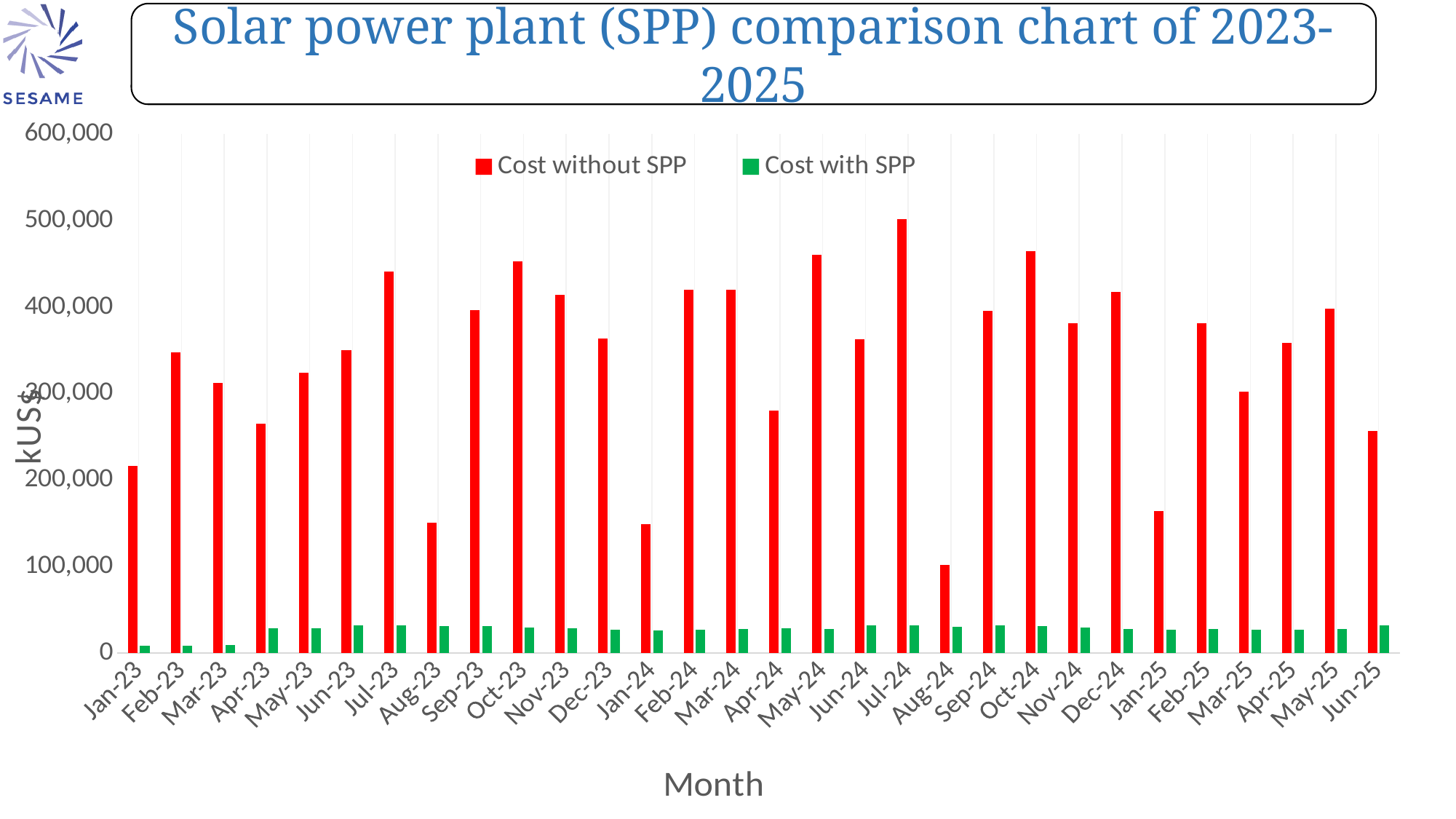
How many months are shown on the x axis? 30 What colour are the bars for the Cost with SPP series? green Is the Cost with SPP for Jul-24 greater or less than 100,000? less Which month has the highest Cost without SPP? Jul-24 Is the Cost without SPP for Oct-24 greater or less than 400,000? greater What kind of chart is shown on the slide? bar chart Which is larger, the Cost without SPP for Dec-23 or for Jan-24? Dec-23 Is the Cost without SPP for Jan-23 greater or less than 200,000? greater Which month has the lowest Cost without SPP? Aug-24 Which is larger, the Cost without SPP for Jun-23 or for Jul-23? Jul-23 How many series does the legend list? 2